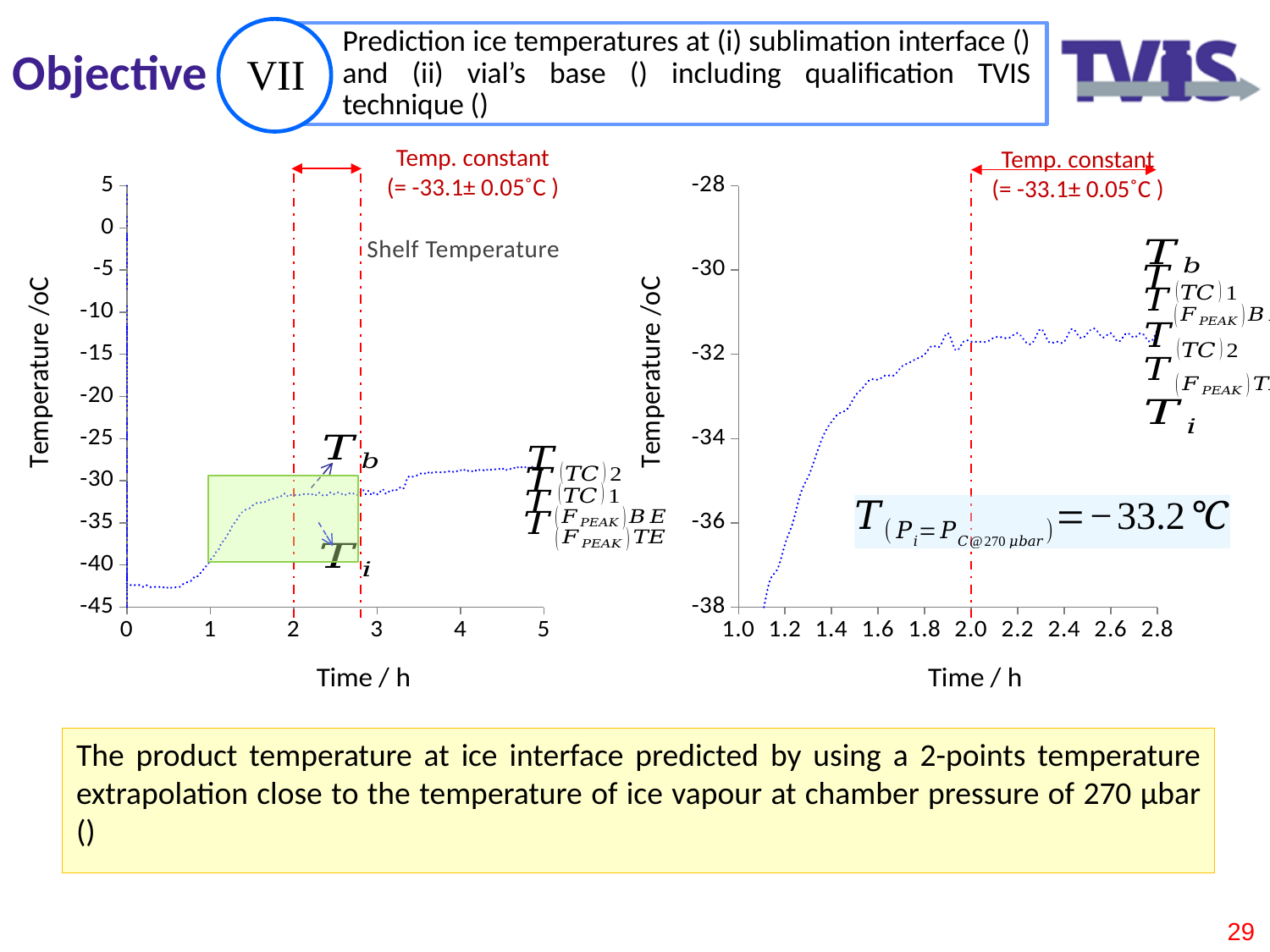
On the right chart, is the temperature at time 1.2 h greater or less than -36? less What kind of chart is the right chart on the slide? line chart On the right chart, how many tick labels are shown on the x axis? 10 On the left chart, is the temperature at time 4 h greater or less than -35? greater On the left chart, is the temperature at time 0 h greater or less than -40? less On the left chart, what is the label of the x axis? Time / h What kind of chart is the left chart on the slide? line chart On the right chart, what is the label of the y axis? Temperature /oC On the right chart, does the temperature rise or fall as time increases from 1.2 h to 1.8 h? rise On the left chart, what is the highest value shown on the y axis? 5 On the left chart, does the temperature rise or fall as time increases from 0 h to 2 h? rise